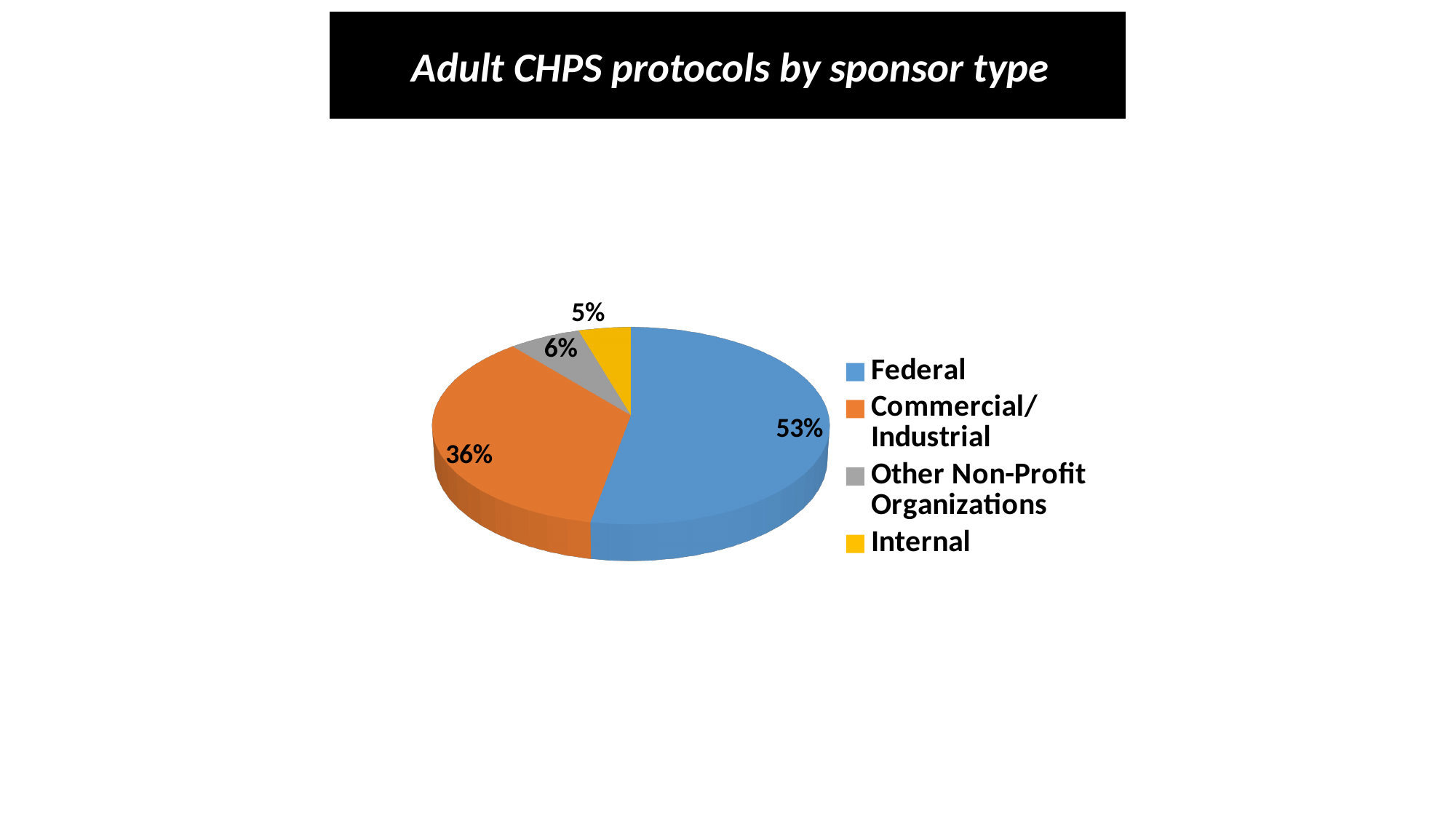
What kind of chart is shown on the slide? Pie chart What colour represents Internal in the legend? Yellow What is the title of the chart? Adult CHPS protocols by sponsor type What is the value shown for Internal? 5% What share of adult CHPS protocols is sponsored by Federal sponsors? 53% How many sponsor types are shown in the pie chart? 4 Which sponsor type has the smallest slice of the pie? Internal Which is larger, the Commercial/Industrial slice or the Other Non-Profit Organizations slice? Commercial/Industrial What percentage of the pie is Commercial/Industrial? 36% Which sponsor type has the largest slice of the pie? Federal What is the difference in percentage points between Federal and Commercial/Industrial? 17 What is the value shown for Other Non-Profit Organizations? 6%